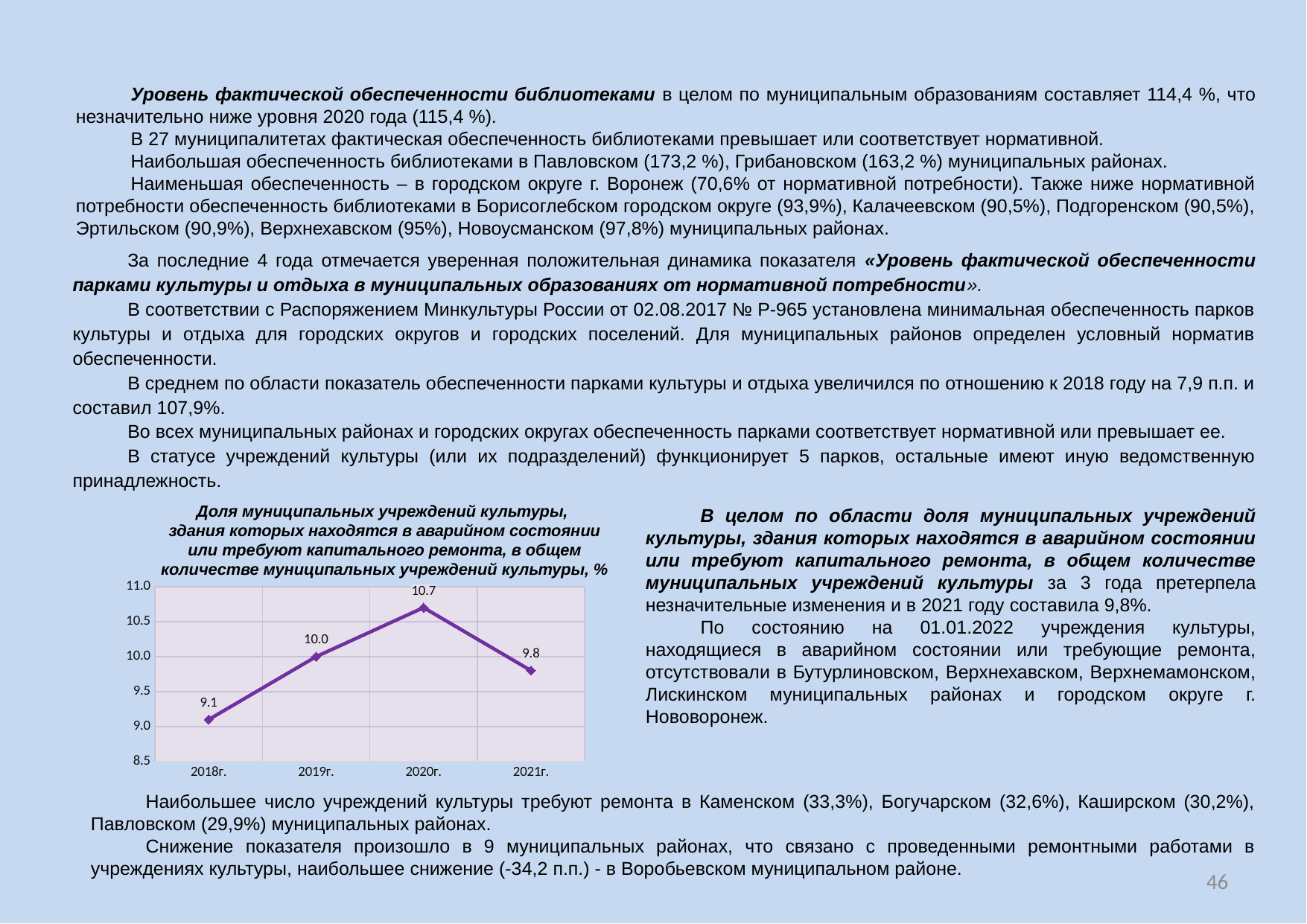
Does the value rise or fall from 2020г. to 2021г.? fall What is the value for 2021г. on the chart? 9.8 Which year has the lowest value on the chart? 2018г. What is the value for 2018г. on the chart? 9.1 What is the value for 2020г. on the chart? 10.7 How many years are plotted on the chart? 4 Is the value for 2019г. greater or less than 9.5? greater Which year has the highest value on the chart? 2020г. What is the difference between the values for 2020г. and 2018г.? 1.6 What is the difference between the values for 2020г. and 2021г.? 0.9 What kind of chart is shown on the slide? line chart Which is larger, the value for 2019г. or the value for 2021г.? 2019г.